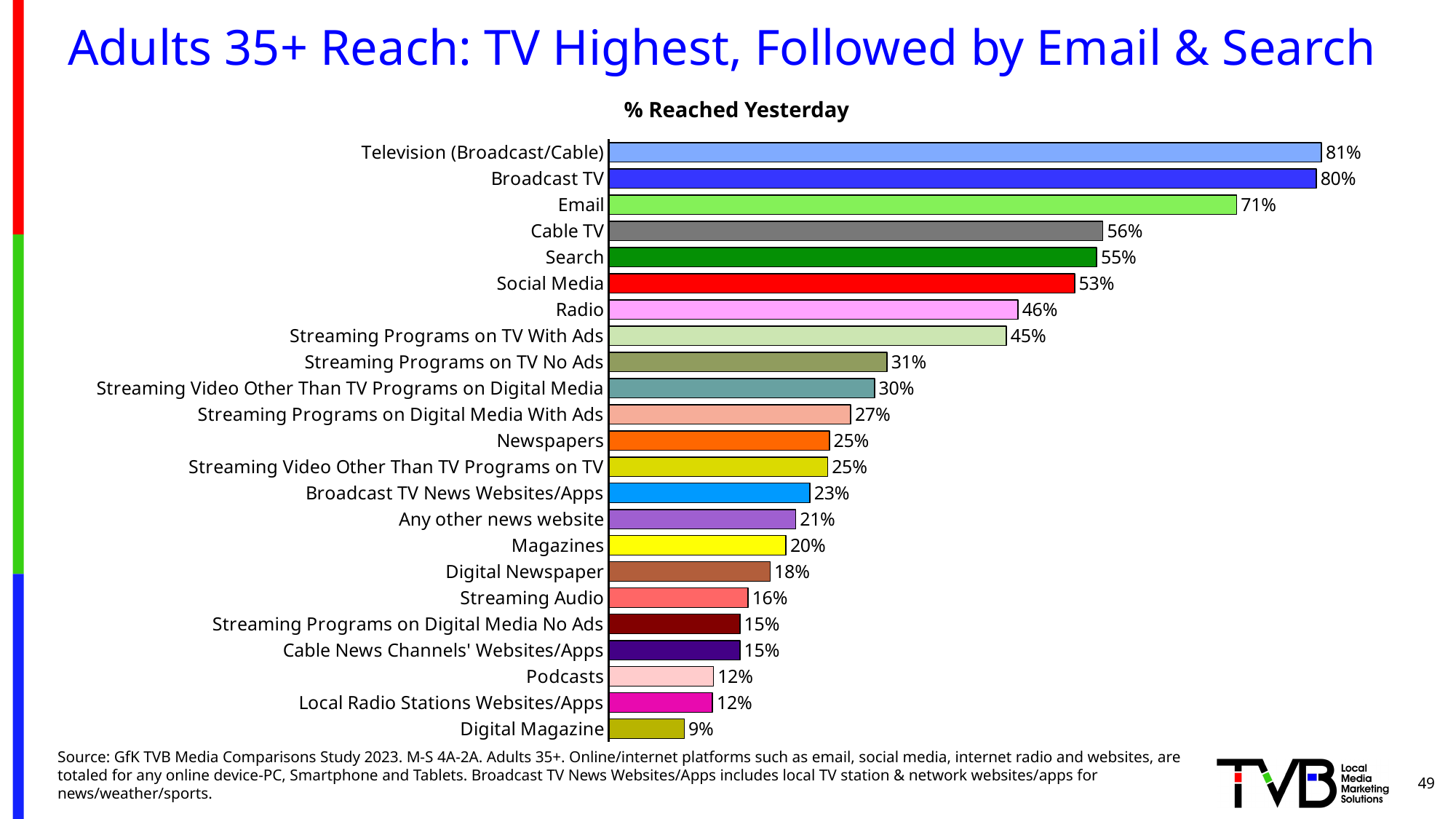
What is the % Reached Yesterday value for Email? 71% Which category has the lowest % Reached Yesterday? Digital Magazine Which has a higher % Reached Yesterday, Search or Social Media? Search What kind of chart is shown on the slide? Bar chart How many categories are shown in the chart? 23 Which category has the highest % Reached Yesterday? Television (Broadcast/Cable) What is the difference in % Reached Yesterday between Broadcast TV and Cable TV? 24% What is the % Reached Yesterday value for Radio? 46% What is the title of the chart? % Reached Yesterday What is the % Reached Yesterday value for Podcasts? 12% What is the difference in % Reached Yesterday between Streaming Programs on TV With Ads and Streaming Programs on TV No Ads? 14% Which has a higher % Reached Yesterday, Magazines or Digital Newspaper? Magazines